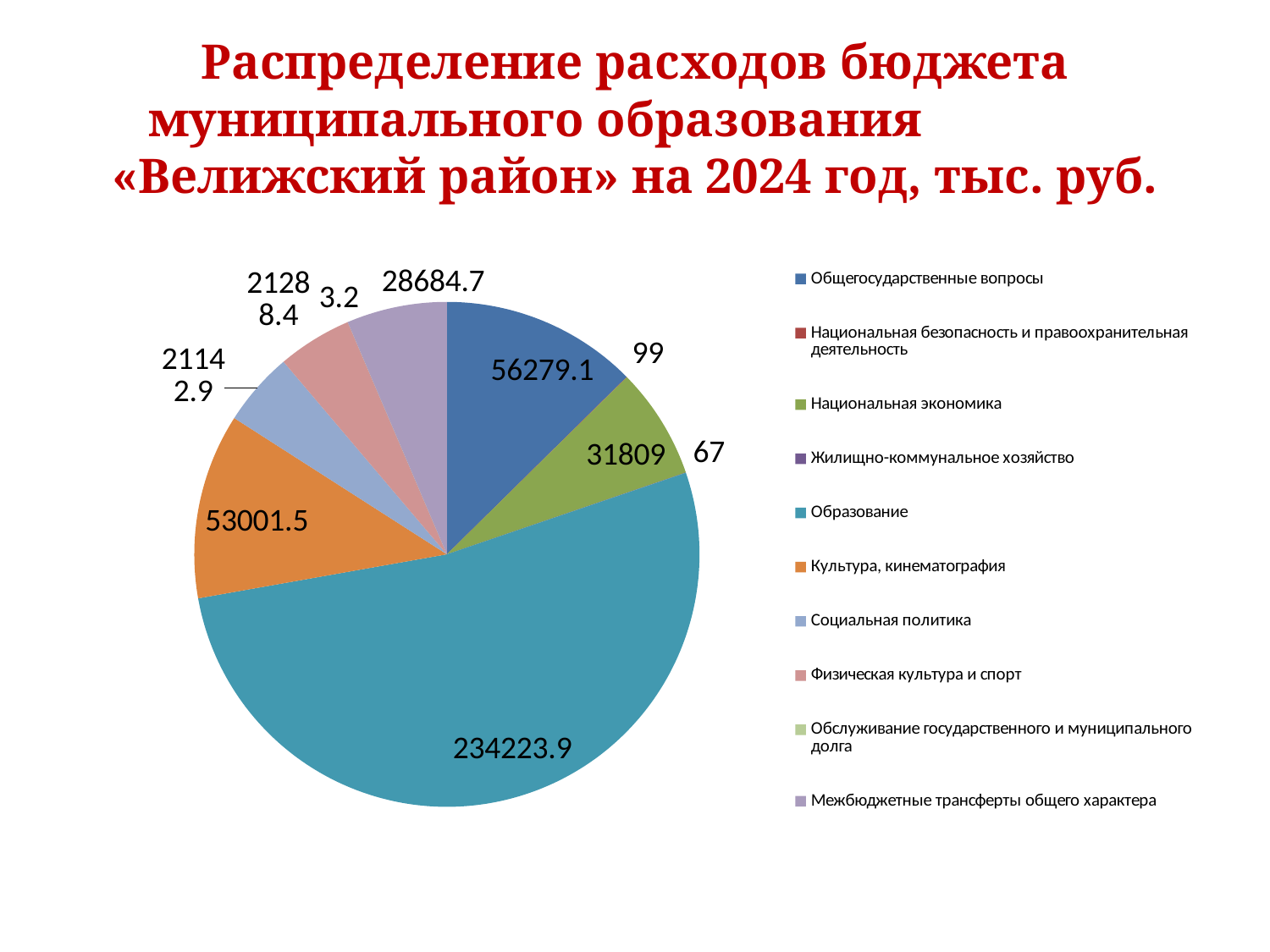
How many categories does the legend of the pie chart list? 10 What is the value for Культура, кинематография in the pie chart? 53001.5 In what units are the values in the chart expressed, according to the slide title? тыс. руб. What is the value for Межбюджетные трансферты общего характера in the pie chart? 28684.7 Which category has the smallest value in the pie chart? Обслуживание государственного и муниципального долга Which category has the largest slice of the pie chart? Образование What kind of chart is shown on the slide? pie chart What is the value for Образование in the pie chart? 234223.9 What is the value for Национальная экономика in the pie chart? 31809 Which is larger in the pie chart: Общегосударственные вопросы or Культура, кинематография? Общегосударственные вопросы What is the difference between the values for Общегосударственные вопросы and Культура, кинематография? 3277.6 What is the value for Общегосударственные вопросы in the pie chart? 56279.1